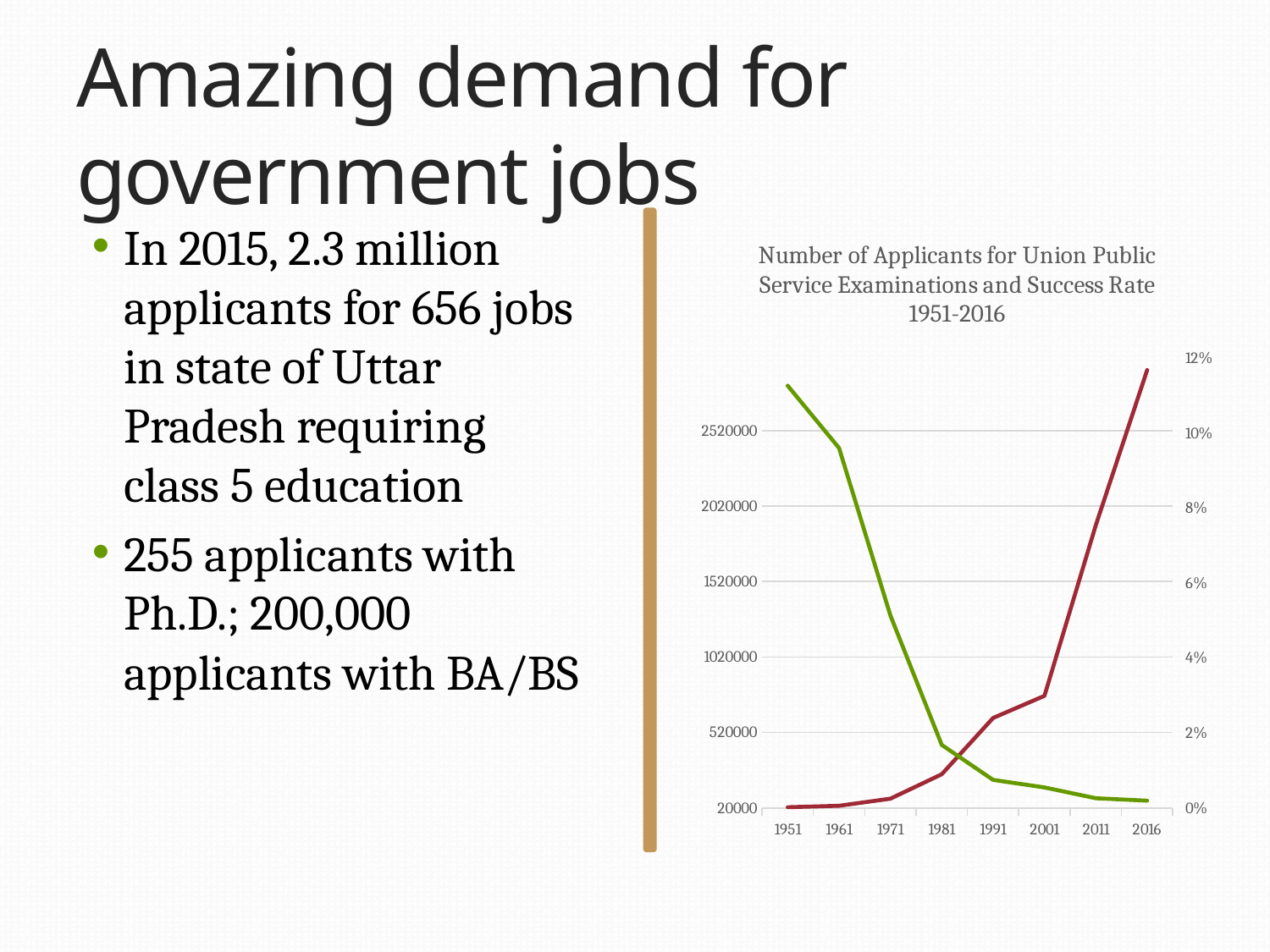
What kind of chart is shown on the slide? line chart Does the red line rise or fall from 1951 to 2016? rise How many years are marked along the x axis of the chart? 8 Does the green line rise or fall from 1951 to 2016? fall What is the highest tick label on the right-hand axis of the chart? 12% What is the title of the chart? Number of Applicants for Union Public Service Examinations and Success Rate 1951-2016